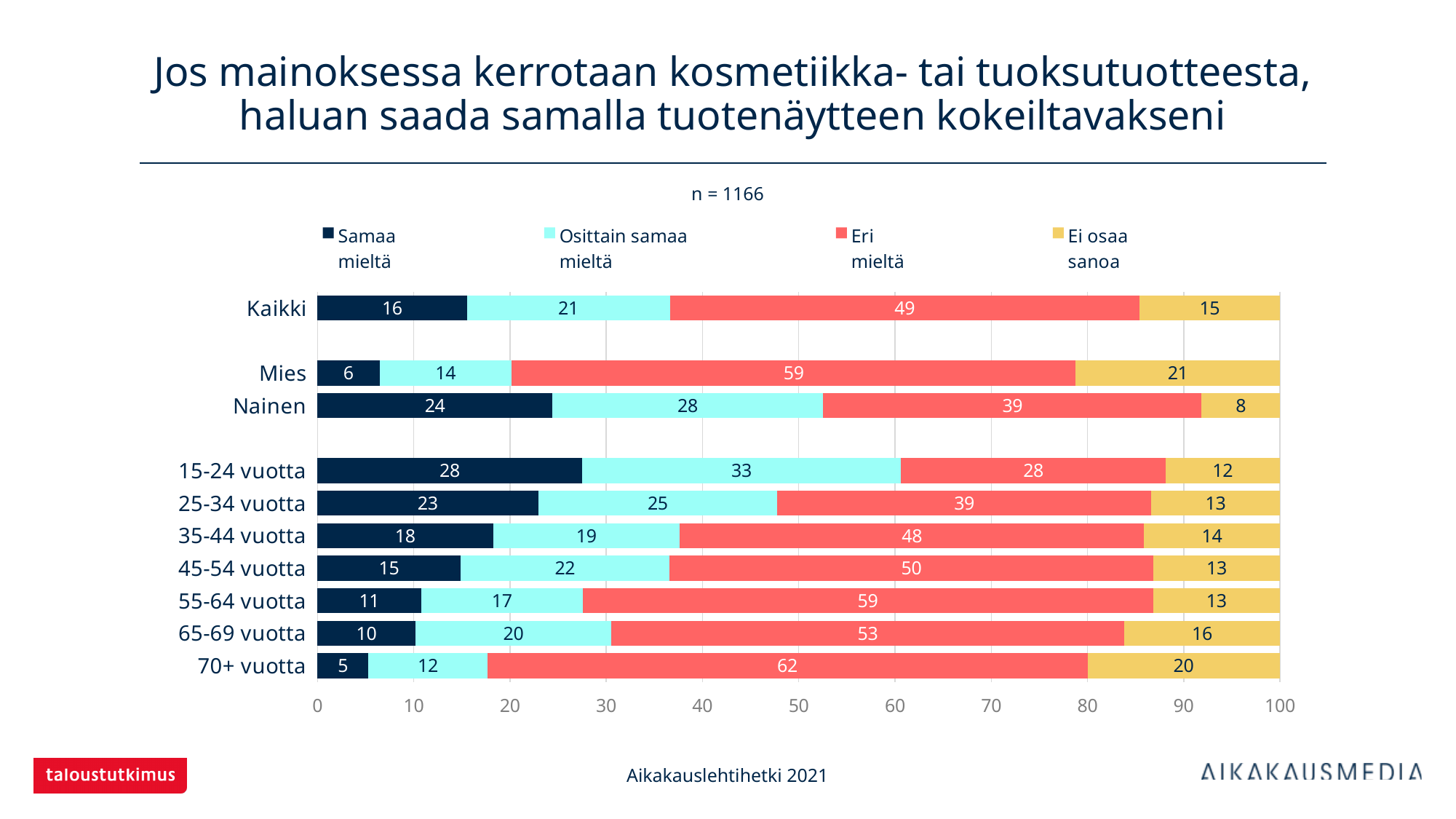
How many categories are plotted on the chart? 10 Which category has the lowest value for 'Samaa mieltä'? 70+ vuotta How many series does the legend list? 4 What is the value of 'Eri mieltä' for Kaikki? 49 Which category has the highest value for 'Eri mieltä'? 70+ vuotta Which has the larger 'Ei osaa sanoa' value, Mies or Nainen? Mies What is the value of 'Samaa mieltä' for Nainen? 24 What is the total of the stacked bar for Mies? 100 What kind of chart is shown on the slide? stacked bar chart What is the difference between the 'Samaa mieltä' values for Nainen and Mies? 18 Does the 'Samaa mieltä' value rise or fall as the age groups go from 15-24 vuotta to 70+ vuotta? fall What is the value of 'Ei osaa sanoa' for 70+ vuotta? 20